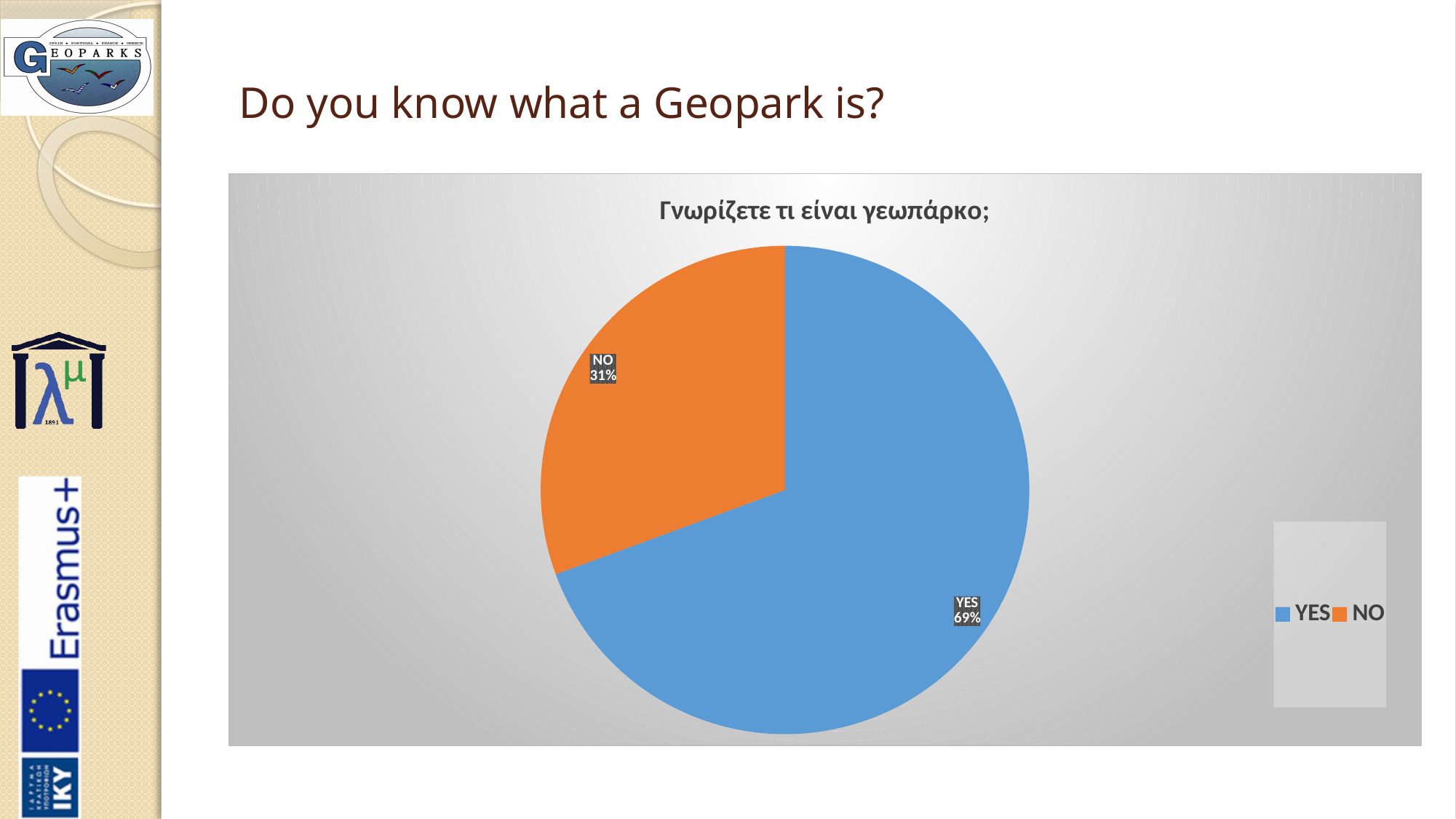
Which answer has the largest share of the pie? YES What colour is the YES slice? blue What is the title of the chart? Γνωρίζετε τι είναι γεωπάρκο; What kind of chart is shown on the slide? pie chart What is the difference in percentage points between the YES and NO slices? 38 Which answer has the smallest share of the pie? NO What percentage of respondents answered YES? 69% How many slices does the pie chart have? 2 What share of the pie does the NO slice represent? 31% How many entries does the legend list? 2 Which slice is larger, YES or NO? YES What percentage of respondents answered NO? 31%